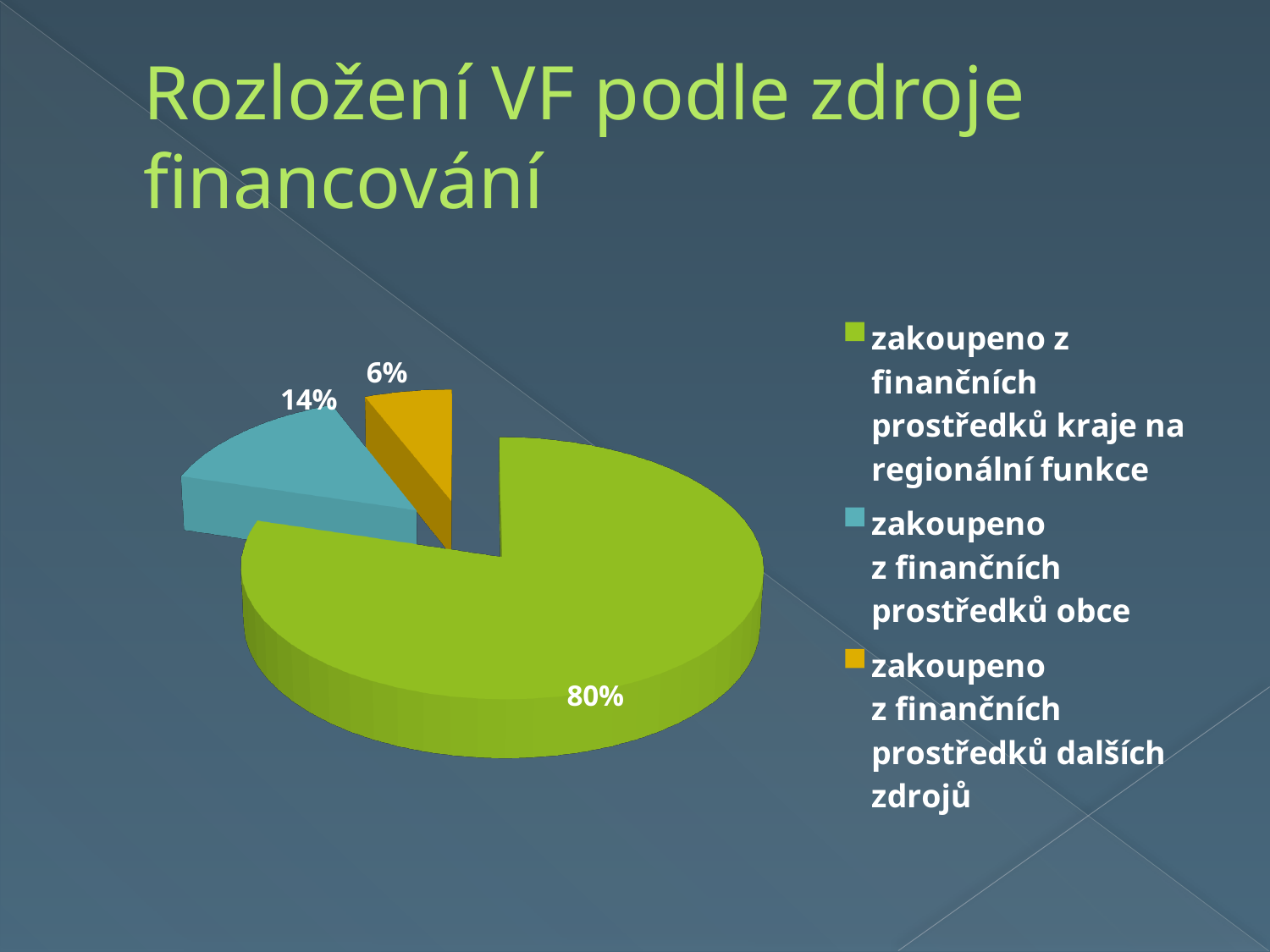
How many slices does the pie chart have? 3 What share of the pie is 'zakoupeno z finančních prostředků dalších zdrojů'? 6% Which is larger: the share for 'zakoupeno z finančních prostředků obce' or for 'zakoupeno z finančních prostředků dalších zdrojů'? zakoupeno z finančních prostředků obce What is the difference in percentage points between the 'kraje na regionální funkce' slice and the 'obce' slice? 66 Which category has the smallest slice of the pie? zakoupeno z finančních prostředků dalších zdrojů What kind of chart is shown on the slide? pie chart Which category has the largest slice of the pie? zakoupeno z finančních prostředků kraje na regionální funkce What share of the pie is 'zakoupeno z finančních prostředků kraje na regionální funkce'? 80% What share of the pie is 'zakoupeno z finančních prostředků obce'? 14% What colour is the slice for 'zakoupeno z finančních prostředků obce'? blue How many entries does the legend list? 3 What is the difference in percentage points between the 'obce' slice and the 'dalších zdrojů' slice? 8